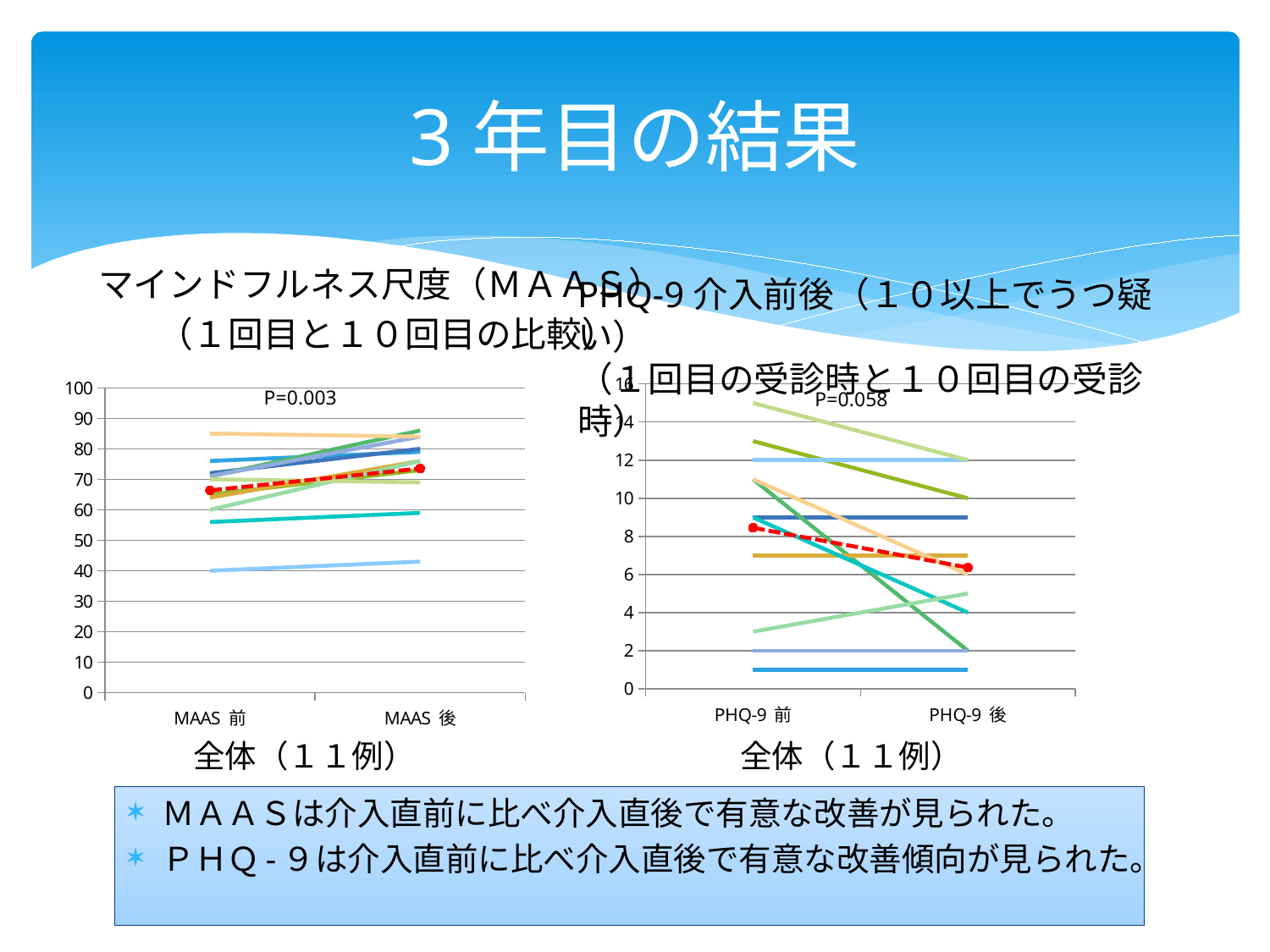
In the left chart (MAAS), does the red dashed line rise or fall from MAAS 前 to MAAS 後? rise In the right chart (PHQ-9), is the value of the red dashed line at PHQ-9 前 greater or less than 10? less What kind of chart is the left chart (MAAS)? line chart In the right chart (PHQ-9), is the value of the red dashed line at PHQ-9 後 greater or less than 8? less What P value is printed on the left chart (MAAS)? P=0.003 What kind of chart is the right chart (PHQ-9)? line chart In the right chart (PHQ-9), how many categories are shown on the x axis? 2 In the left chart (MAAS), is the value of the red dashed line at MAAS 後 greater or less than 80? less In the left chart (MAAS), how many categories are shown on the x axis? 2 In the right chart (PHQ-9), does the red dashed line rise or fall from PHQ-9 前 to PHQ-9 後? fall What P value is printed on the right chart (PHQ-9)? P=0.058